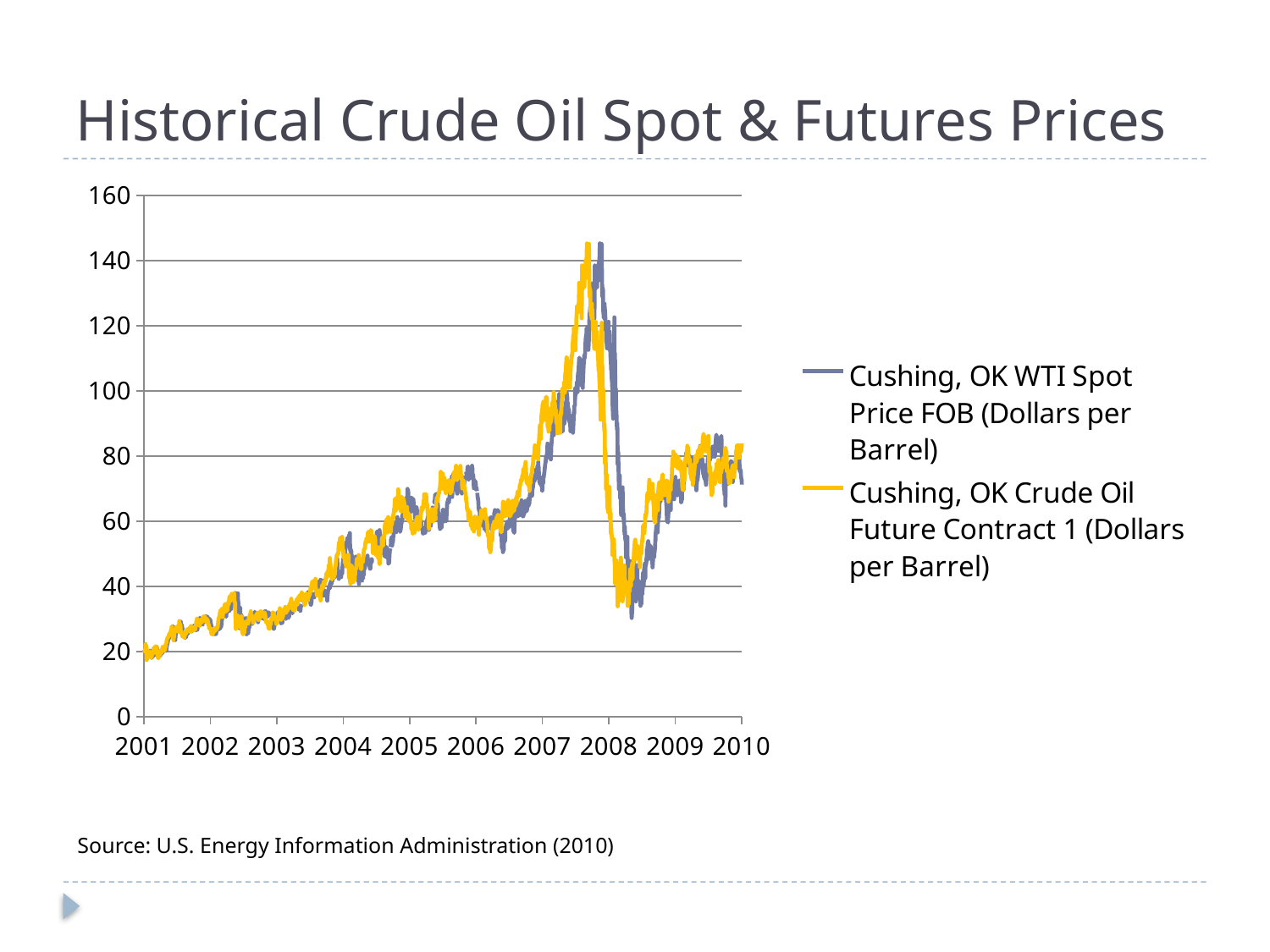
Is the lowest value of the Cushing, OK WTI Spot Price FOB series in early 2009 greater or less than 40? less What is the highest value shown on the y axis? 160 Did the Cushing, OK WTI Spot Price FOB series generally rise or fall from 2001 to its peak in 2008? rise Which colour is used for the Cushing, OK WTI Spot Price FOB series? grey Is the value of the Cushing, OK WTI Spot Price FOB series at the start of 2001 greater or less than 40? less How many year labels are shown on the x axis? 10 What is the title of the chart on the slide? Historical Crude Oil Spot & Futures Prices Did the Cushing, OK WTI Spot Price FOB series rise or fall between its 2008 peak and early 2009? fall What kind of chart is shown on the slide? line chart How many series does the legend list? 2 Is the value of the Cushing, OK Crude Oil Future Contract 1 series at the end of 2009 greater or less than 60? greater